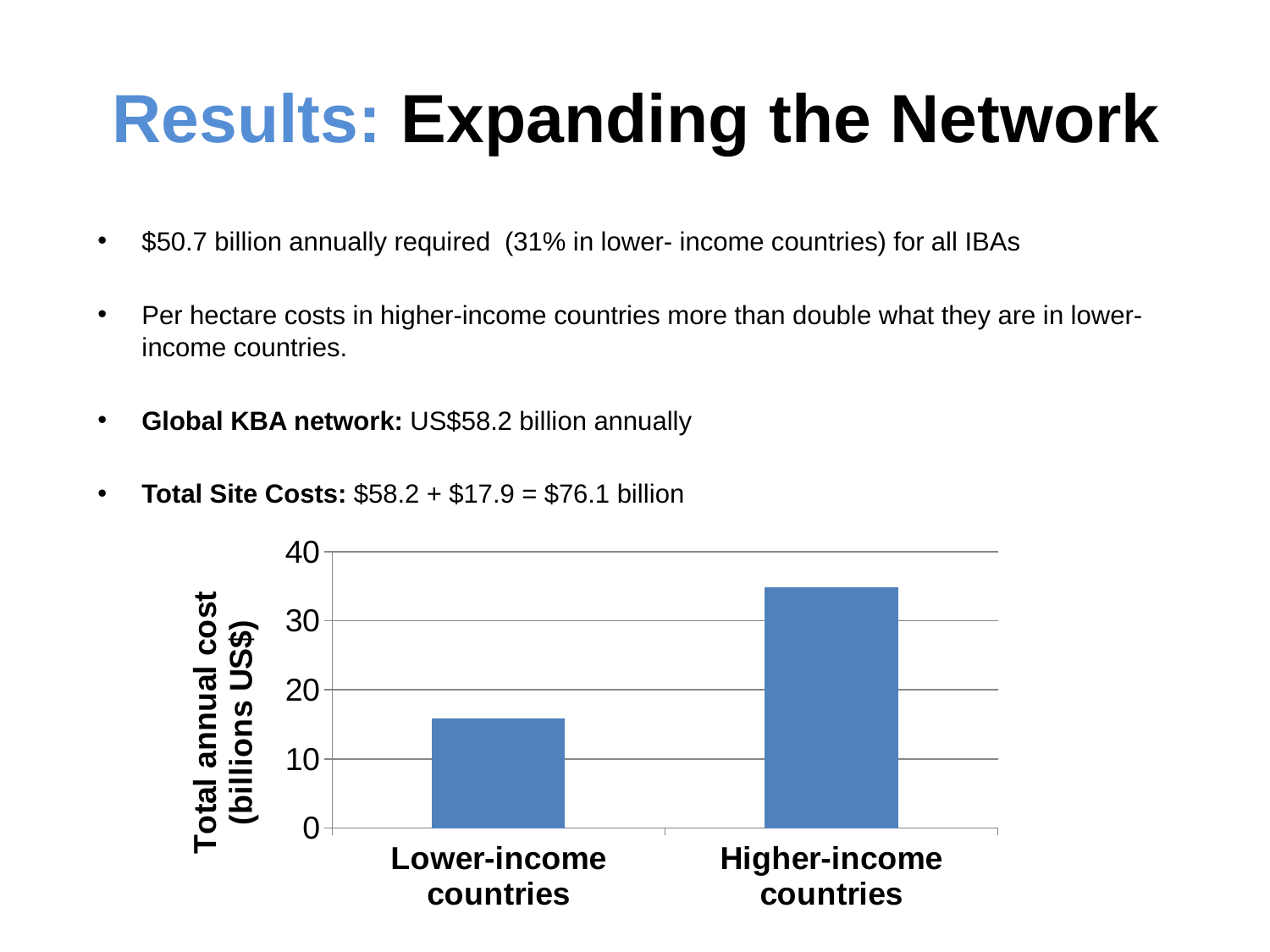
How many categories are plotted in the chart? 2 What is the title of the vertical axis in the chart? Total annual cost (billions US$) Is the value for Lower-income countries greater or less than 20? less Is the value for Higher-income countries greater or less than 30? greater Which is larger in the chart: the value for Lower-income countries or the value for Higher-income countries? Higher-income countries What is the highest value shown on the vertical axis of the chart? 40 Is the value for Higher-income countries greater or less than 40? less What kind of chart is shown on the slide? bar chart Do the bar values rise or fall moving from Lower-income countries to Higher-income countries along the x axis? rise Which category has the highest total annual cost in the chart? Higher-income countries Which category has the lowest total annual cost in the chart? Lower-income countries